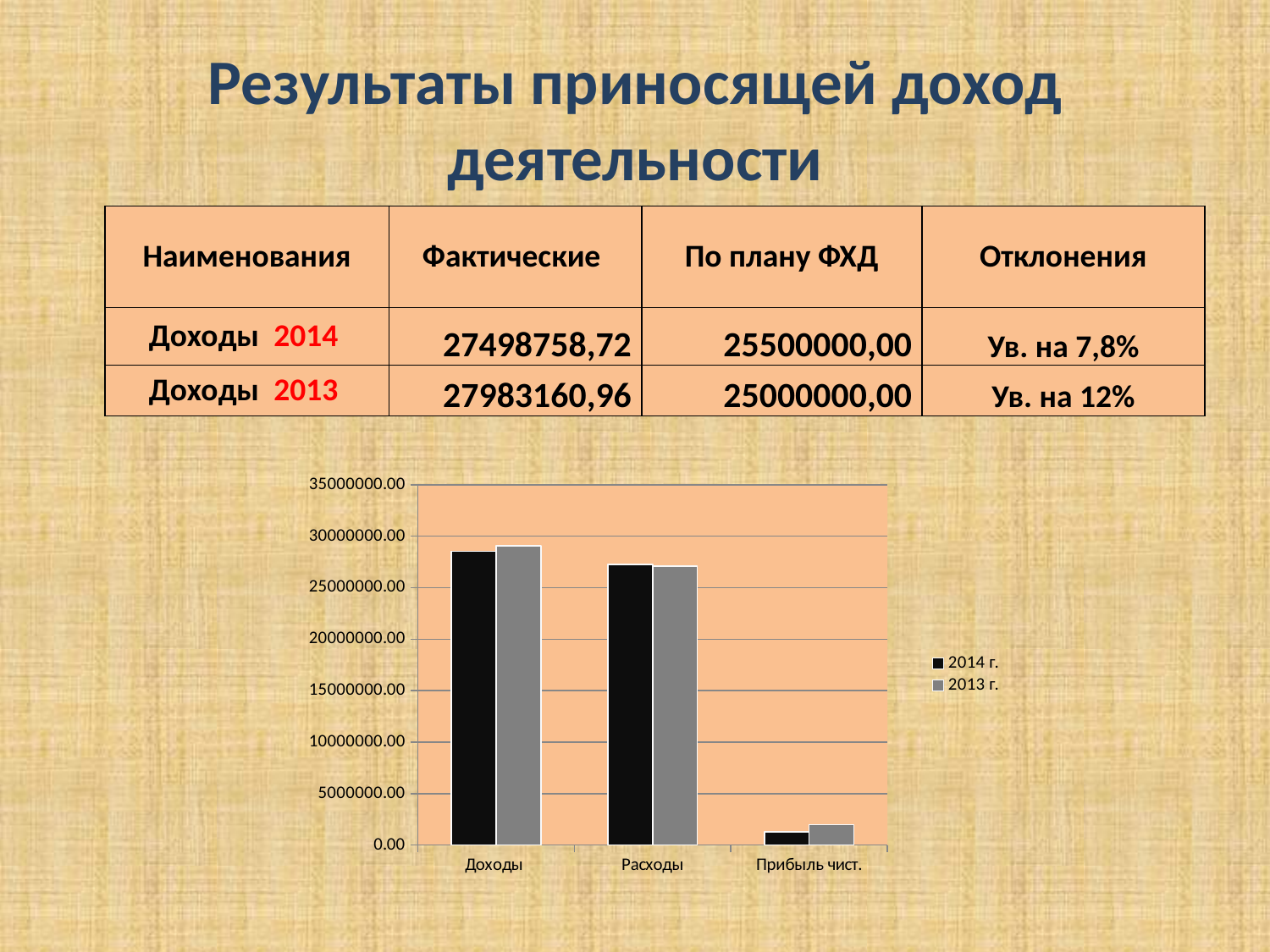
Is the value for Доходы in the 2013 г. series greater or less than 30000000.00? less Is the value for Доходы in the 2014 г. series greater or less than 25000000.00? greater How many categories are shown on the x axis of the chart? 3 Which category has the highest value for the 2013 г. series? Доходы Which series are listed in the chart legend? 2014 г. and 2013 г. What colour are the bars for the 2014 г. series? black For Прибыль чист., which series has the larger value, 2014 г. or 2013 г.? 2013 г. How many series does the chart legend list? 2 Is the value for Расходы in the 2013 г. series greater or less than 20000000.00? greater What kind of chart is shown on the slide? bar chart Which category has the lowest value for the 2014 г. series? Прибыль чист.